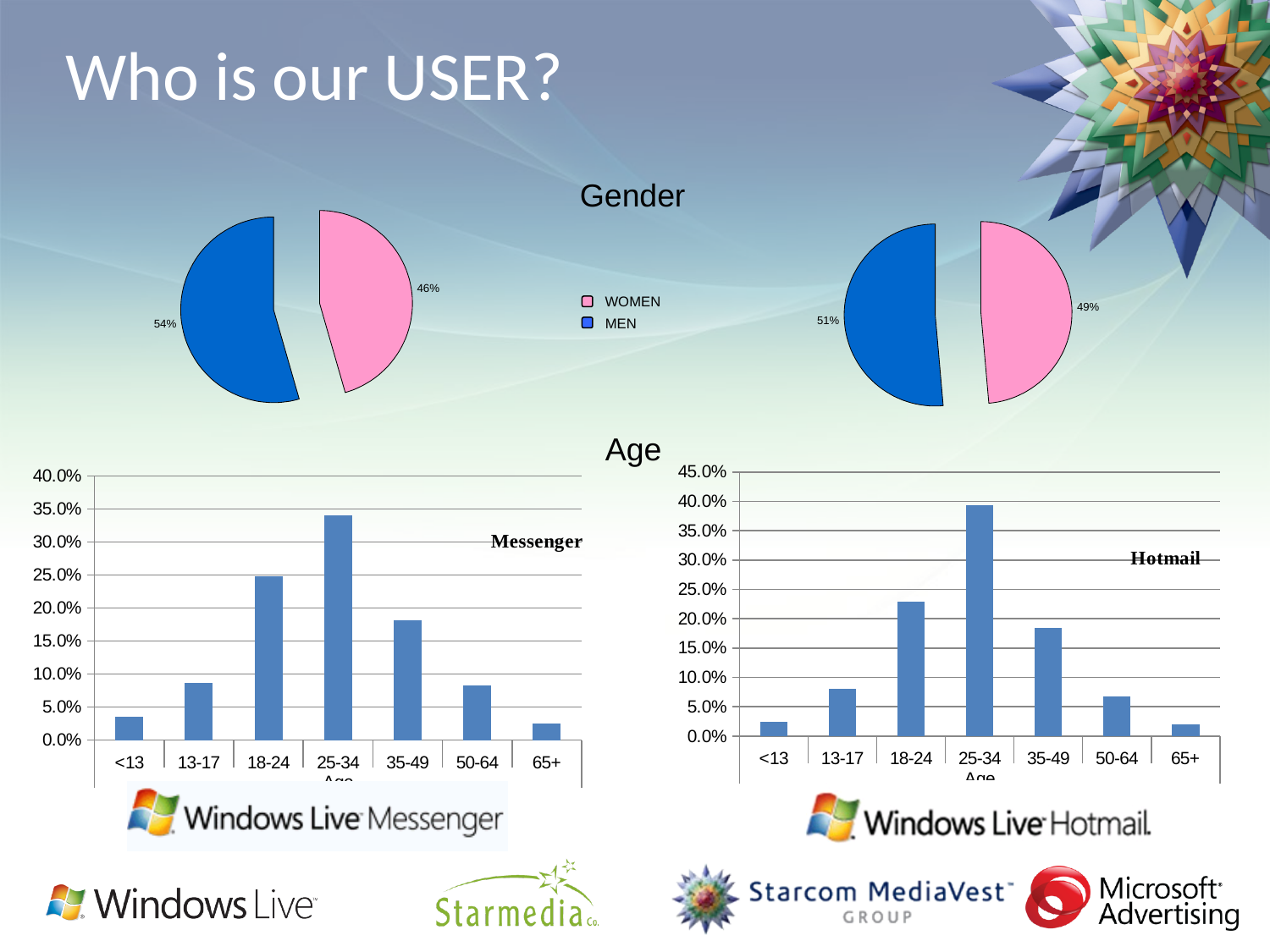
In the right Gender pie chart, what share is labelled for MEN? 51% In the Messenger age bar chart, which age group has the highest value? 25-34 In the right Gender pie chart, which slice is larger, MEN or WOMEN? MEN In the left Gender pie chart, what is the difference between the MEN and WOMEN shares? 8% In the left Gender pie chart, what share is labelled for WOMEN? 46% In the Messenger age bar chart, is the value for 18-24 greater or less than 20.0%? greater In the right Gender pie chart, what share is labelled for WOMEN? 49% How many age groups are shown on the x axis of the Hotmail age bar chart? 7 In the Hotmail age bar chart, which age group has the highest value? 25-34 In the Messenger age bar chart, which age group has the lowest value? 65+ In the Hotmail age bar chart, is the value for 25-34 greater or less than 35.0%? greater In the left Gender pie chart, what share is labelled for MEN? 54%